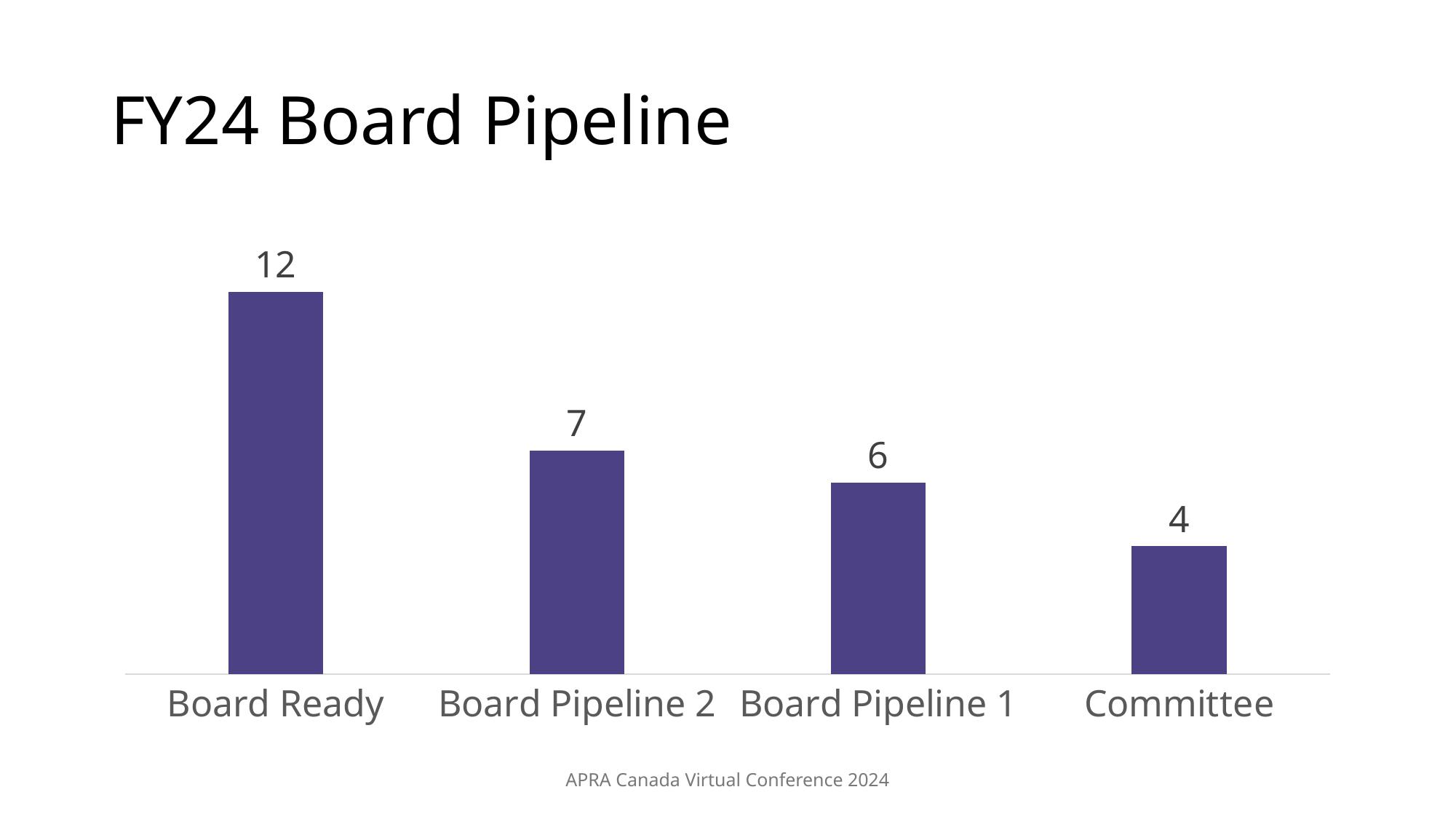
Which is larger, the value for Board Pipeline 2 or the value for Committee? Board Pipeline 2 What is the difference between the values for Board Pipeline 2 and Board Pipeline 1? 1 What kind of chart is shown on the slide? Bar chart What is the value for Board Pipeline 1? 6 Do the values rise or fall from left to right across the categories? Fall What is the difference between the values for Board Ready and Committee? 8 How many categories are shown in the chart? 4 What is the value for Board Ready? 12 What is the value for Board Pipeline 2? 7 Which category has the highest value? Board Ready Which category has the lowest value? Committee What is the value for Committee? 4